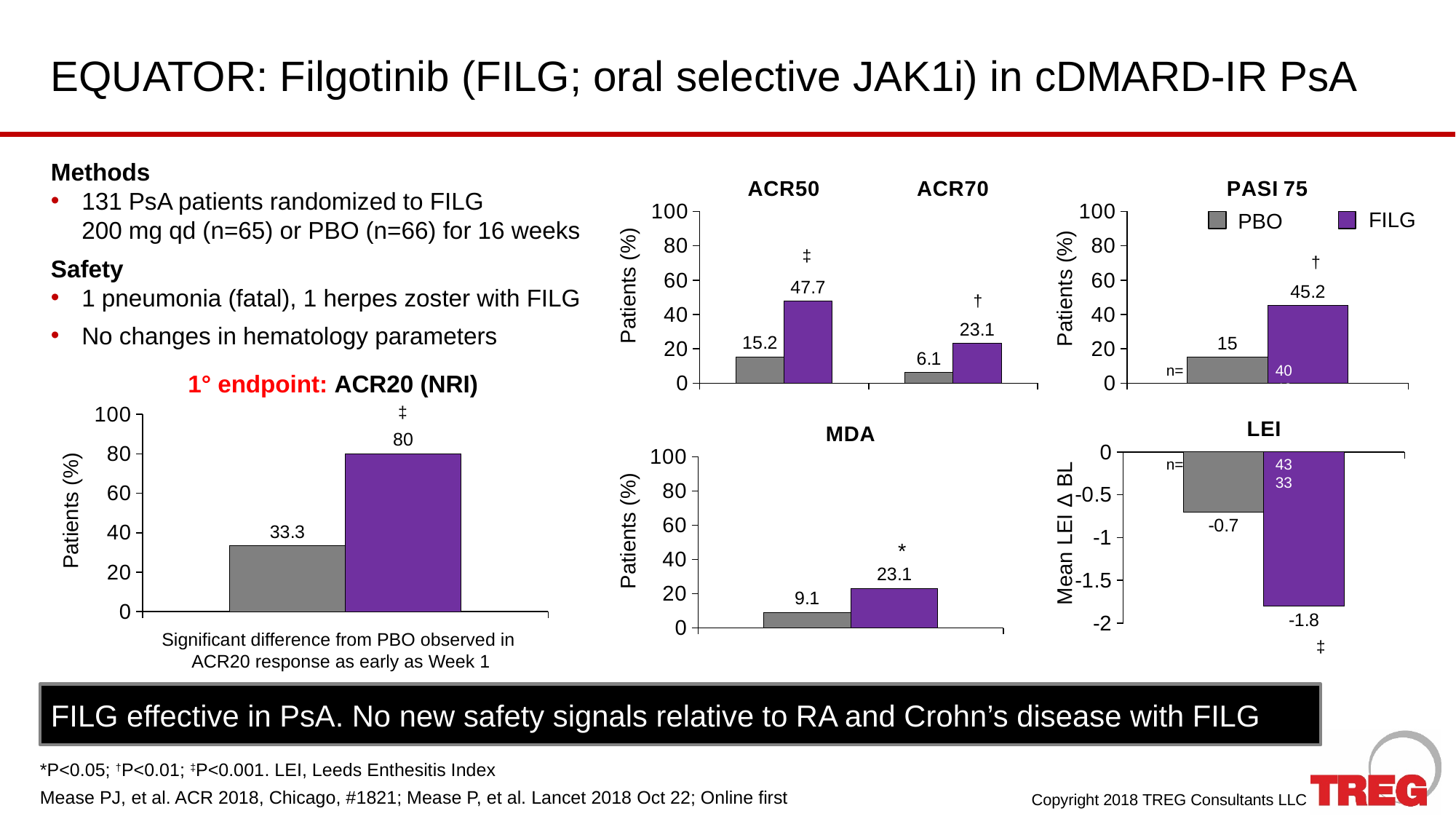
In the ACR50/ACR70 chart, what is the FILG value for ACR50? 47.7 In the ACR20 (NRI) chart, what is the value for PBO? 33.3 In the LEI chart, what is the mean change from baseline for FILG? -1.8 In the ACR50/ACR70 chart, which is larger: the FILG value for ACR50 or the FILG value for ACR70? ACR50 In the MDA chart, what is the value for PBO? 9.1 How many series does the legend in the PASI 75 chart list? 2 In the ACR20 (NRI) chart, what is the value for FILG? 80 In the LEI chart, what is the mean change from baseline for PBO? -0.7 In the ACR50/ACR70 chart, what is the PBO value for ACR70? 6.1 In the PASI 75 chart, what is the difference between the FILG and PBO values? 30.2 In the PASI 75 chart, what is the value for FILG? 45.2 In the ACR20 (NRI) chart, what is the difference between the FILG and PBO values? 46.7